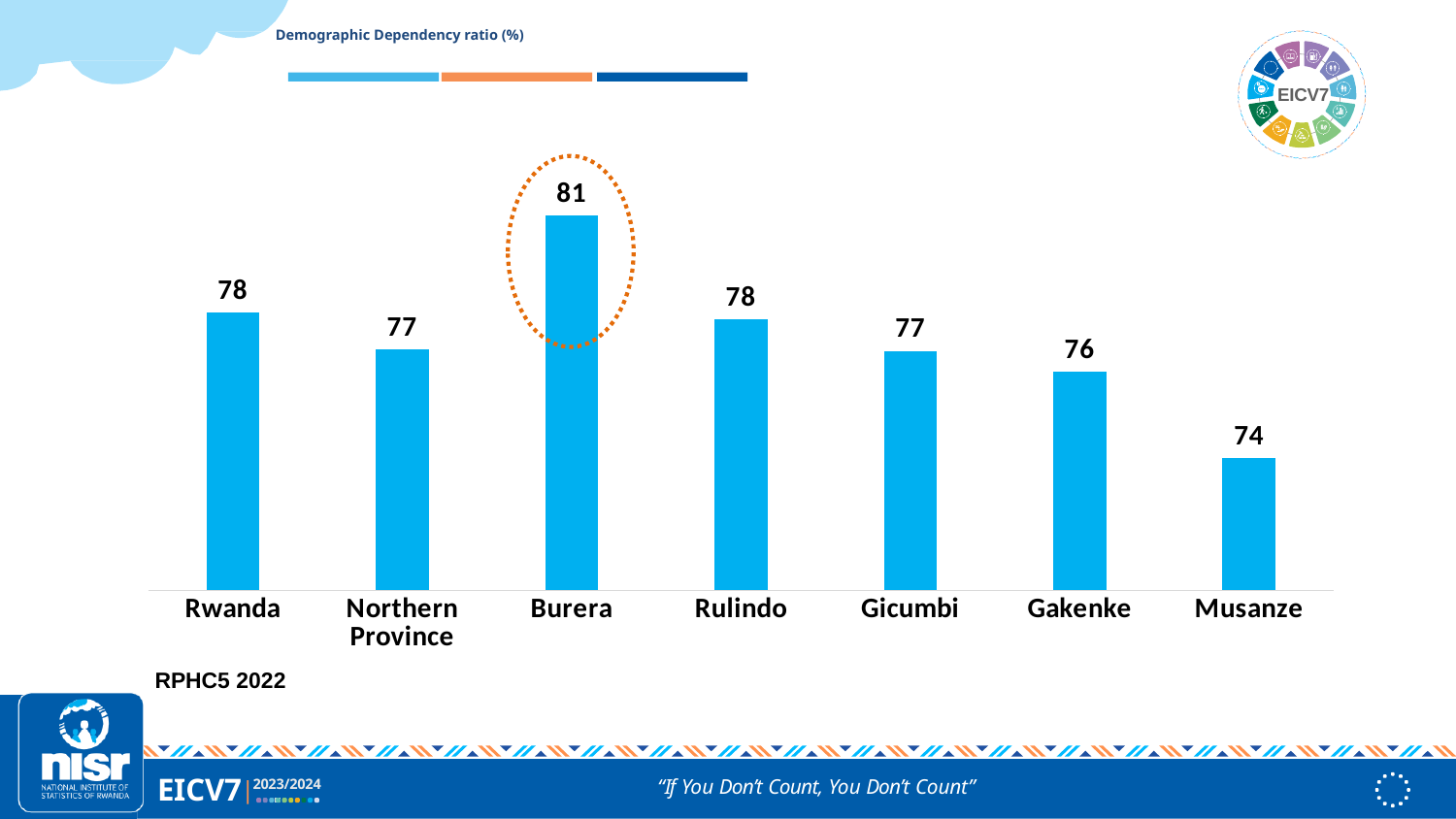
Which category has the highest demographic dependency ratio? Burera What kind of chart is shown on the slide? Bar chart How many categories are shown on the chart? 7 What is the title of the chart? Demographic Dependency ratio (%) What is the demographic dependency ratio for Musanze? 74 What is the demographic dependency ratio for Burera? 81 What is the demographic dependency ratio for Northern Province? 77 Which category has the lowest demographic dependency ratio? Musanze Which has a higher demographic dependency ratio, Rulindo or Gicumbi? Rulindo What is the difference between the demographic dependency ratio of Burera and Musanze? 7 What is the difference between the demographic dependency ratio of Rwanda and Gakenke? 2 What is the demographic dependency ratio for Gakenke? 76